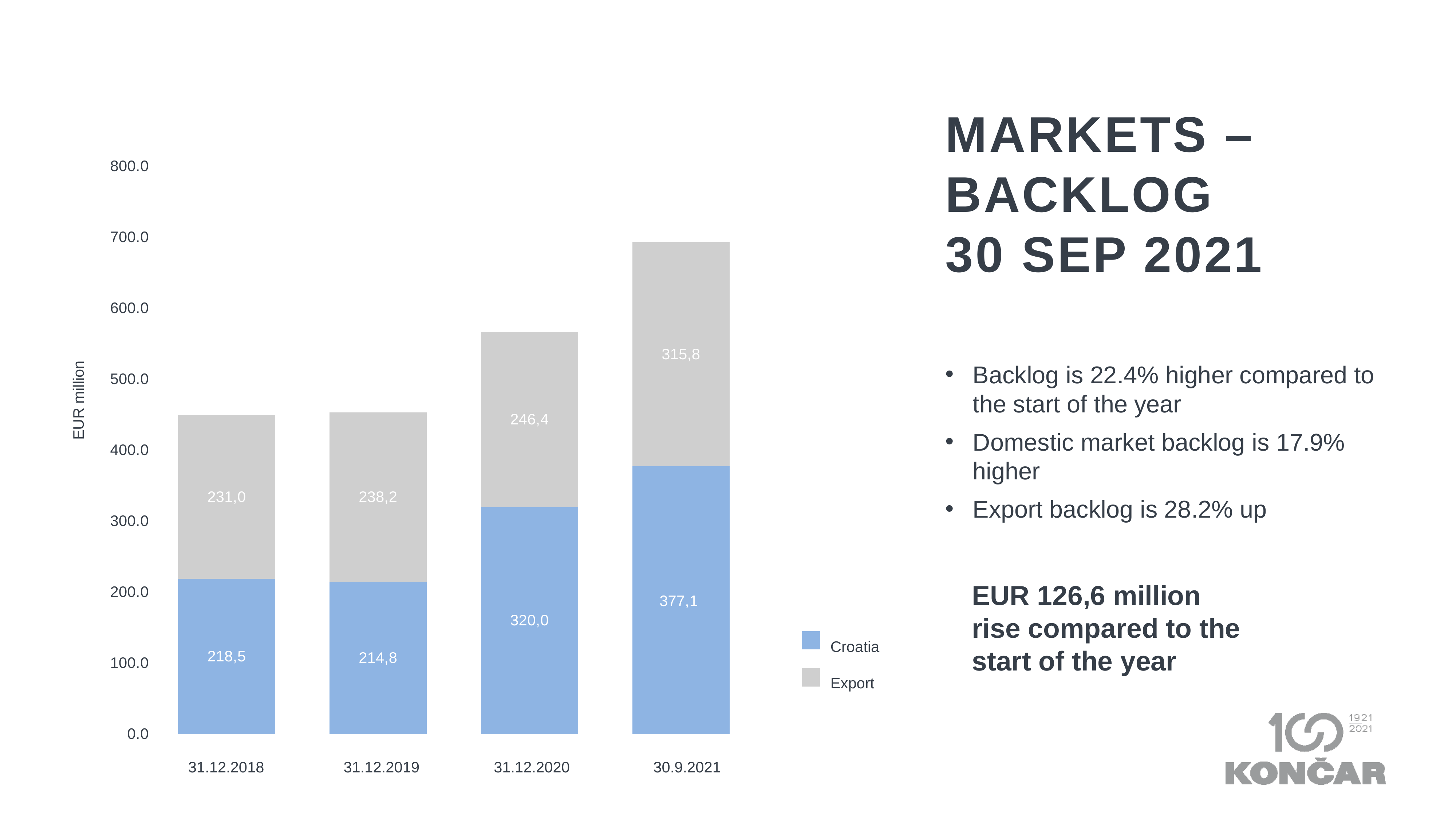
What is the Export value for 30.9.2021? 315,8 How many dates are shown on the x axis? 4 What is the difference between the Export values for 30.9.2021 and 31.12.2020? 69,4 Which date has the highest Croatia value? 30.9.2021 What is the total of the stacked bar for 30.9.2021? 692,9 What kind of chart is shown on the slide? Stacked bar chart How many series does the legend list? 2 Which date has the lowest Croatia value? 31.12.2019 What is the Croatia value for 31.12.2020? 320,0 What is the total of the stacked bar for 31.12.2018? 449,5 What is the Export value for 31.12.2018? 231,0 Which is larger for 31.12.2019, the Croatia value or the Export value? Export